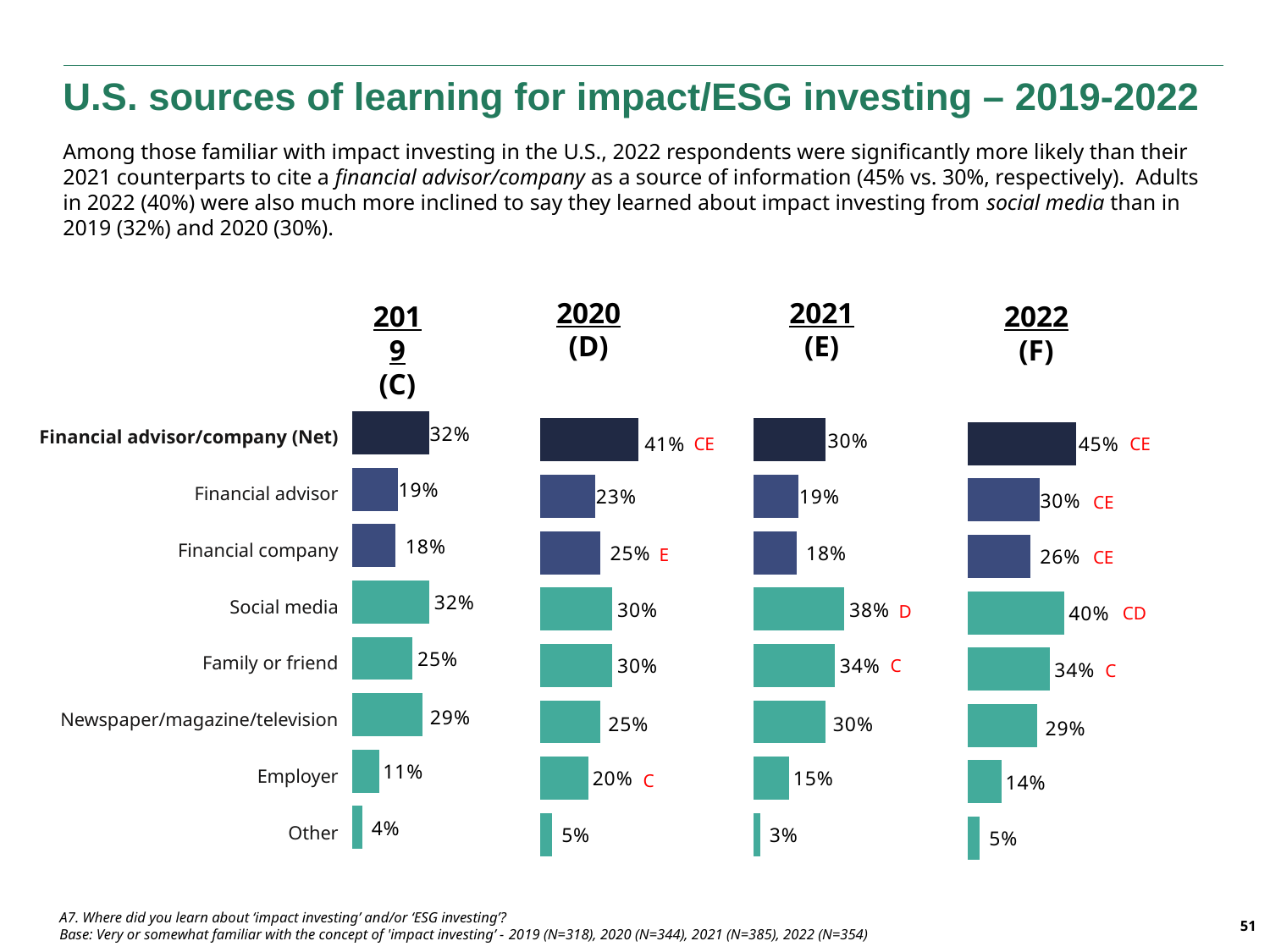
In the 2020 (D) chart, which is larger: Financial advisor or Financial company? Financial company What is the difference between the Financial advisor/company (Net) values in the 2022 (F) chart and the 2021 (E) chart? 15% What is the difference between Social media and Family or friend in the 2022 (F) chart? 6% How many separate year charts are shown on the slide? 4 In the 2021 (E) chart, what is the value for Social media? 38% What kind of chart is used to show the 2022 (F) data? Bar chart In the 2022 (F) chart, what is the value for Financial advisor/company (Net)? 45% In the 2020 (D) chart, what is the value for Employer? 20% In the 2019 (C) chart, what is the value for Newspaper/magazine/television? 29% In the 2021 (E) chart, which category has the highest value? Social media How many categories are shown in the 2019 (C) chart? 8 In the 2022 (F) chart, which category has the lowest value? Other